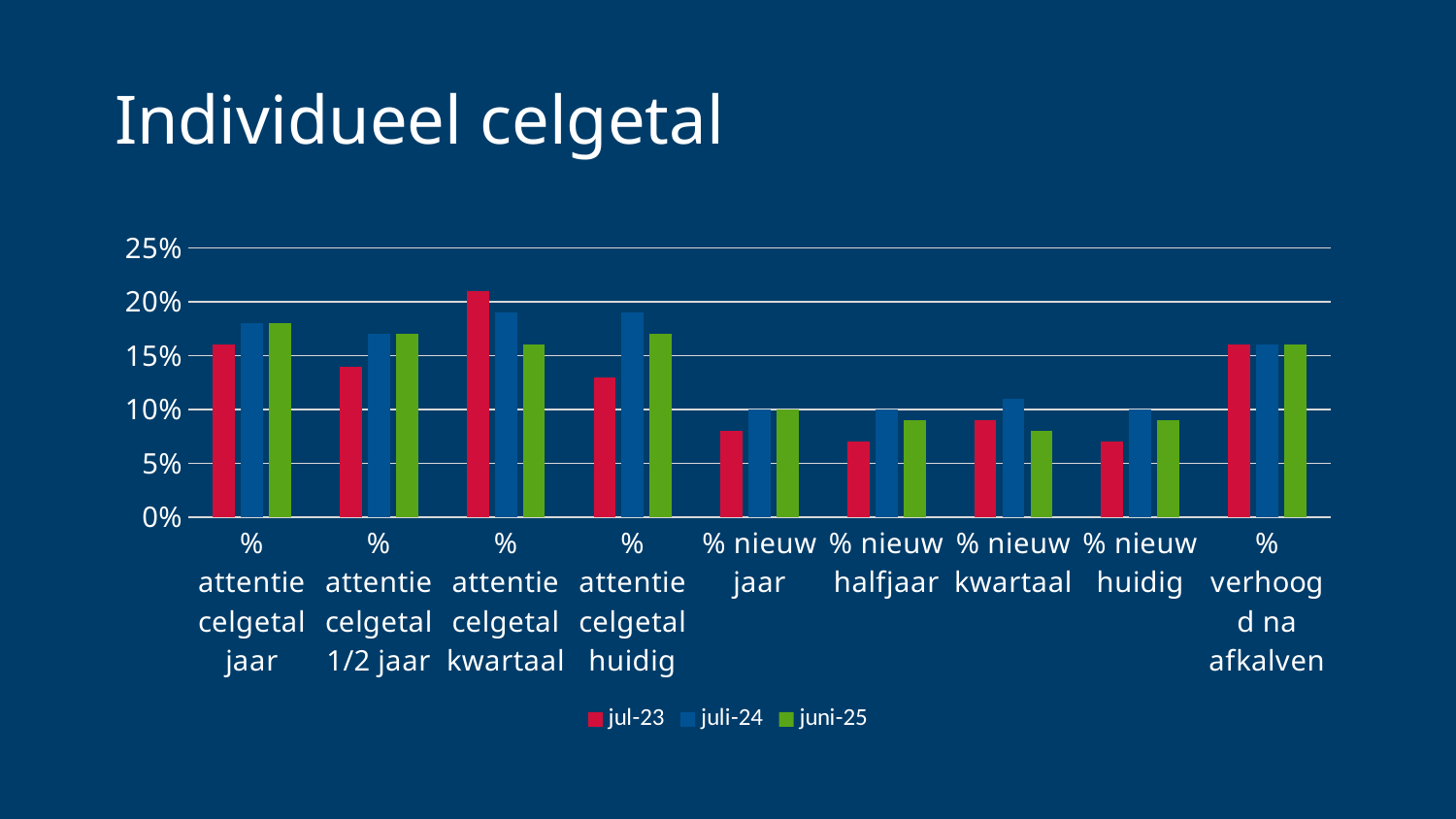
How many categories are shown on the x axis? 9 Is the jul-23 value for % nieuw jaar greater or less than 10%? less Is the juli-24 value for % attentie celgetal huidig greater or less than 15%? greater Is the jul-23 value for % attentie celgetal 1/2 jaar greater or less than 15%? less What kind of chart is shown on the slide? bar chart Which colour represents the jul-23 series in the legend? red Which category has the highest jul-23 value? % attentie celgetal kwartaal For % attentie celgetal huidig, which is larger: the jul-23 value or the juli-24 value? juli-24 How many series does the legend list? 3 For % attentie celgetal kwartaal, which is larger: the jul-23 value or the juli-24 value? jul-23 What is the title of the chart? Individueel celgetal